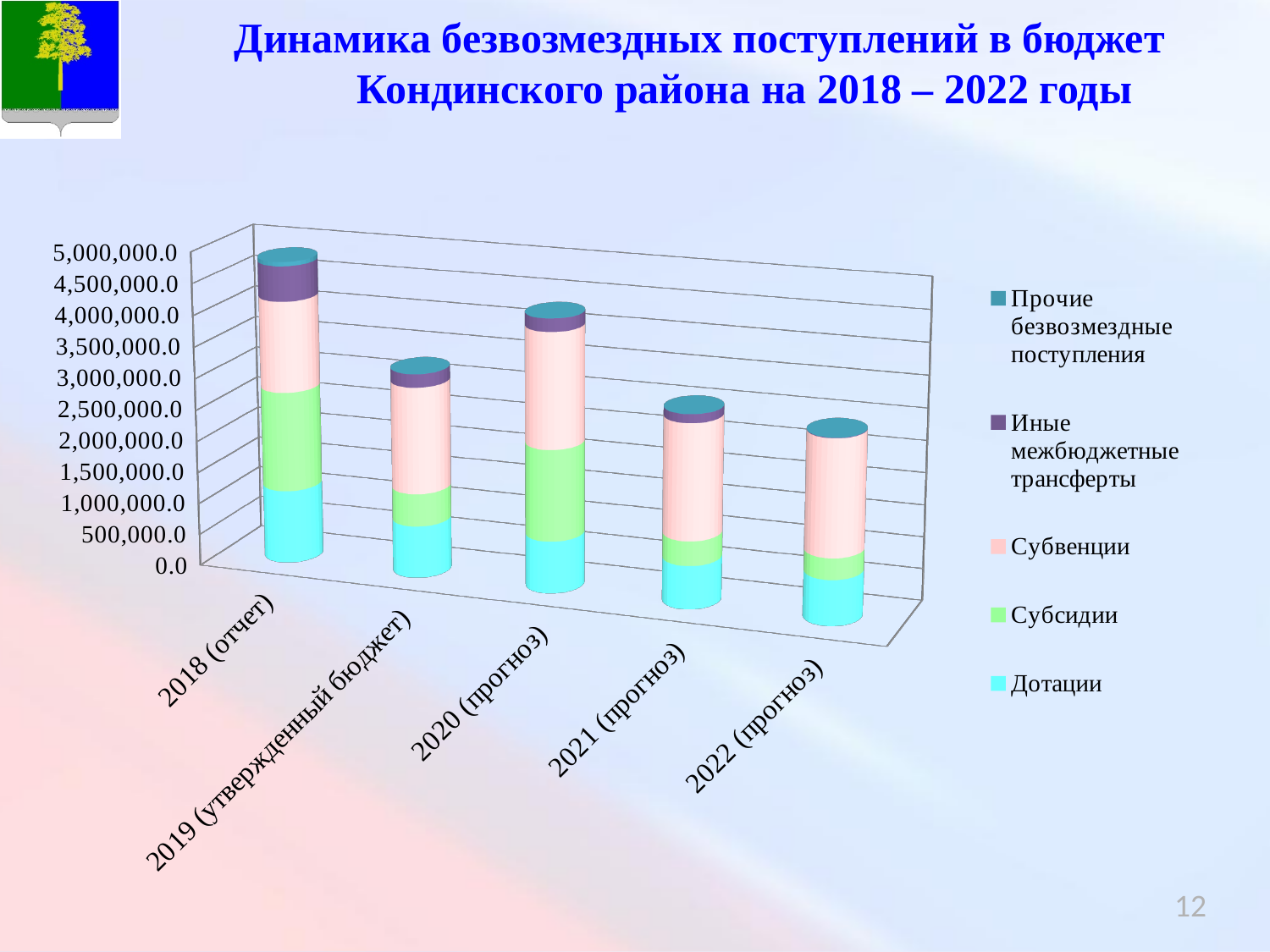
How many categories (years) are shown on the x axis of the chart? 5 Which series forms the bottom segment of each stacked bar? Дотации Which stacked bar is taller: 2019 (утвержденный бюджет) or 2020 (прогноз)? 2020 (прогноз) What is the title of the chart on the slide? Динамика безвозмездных поступлений в бюджет Кондинского района на 2018 – 2022 годы What kind of chart is shown on the slide? Stacked bar chart Which category has the tallest stacked bar? 2018 (отчет) Do the stacked bar totals generally rise or fall from 2018 to 2022? fall Which stacked bar is taller: 2018 (отчет) or 2021 (прогноз)? 2018 (отчет) Which category has the shortest stacked bar? 2022 (прогноз) How many series does the chart legend list? 5 Is the total for 2018 (отчет) greater or less than 3,000,000.0? greater